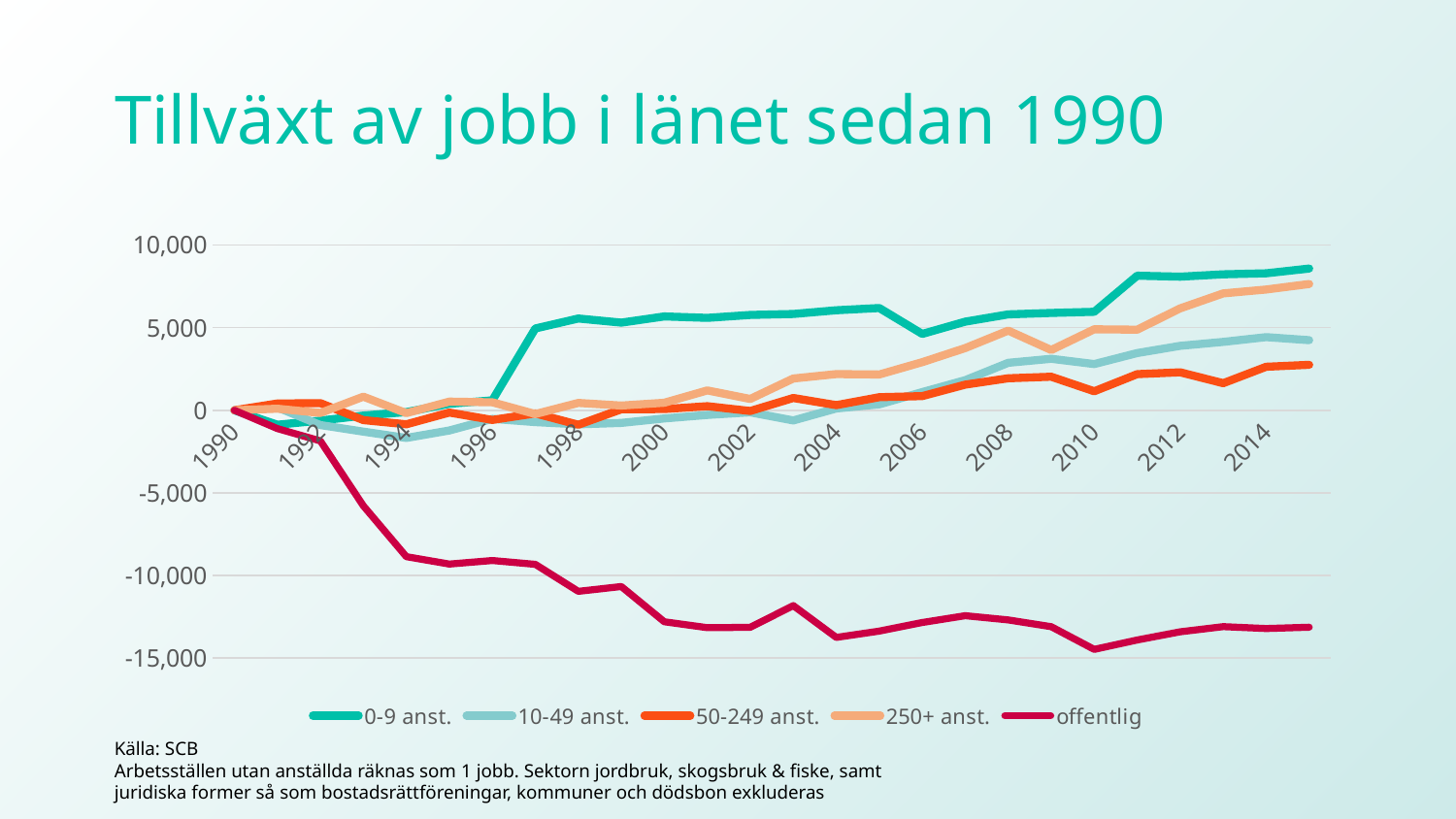
How many series does the legend list? 5 Is the value for offentlig in 2014 greater or less than -10,000? less What is the title of the chart? Tillväxt av jobb i länet sedan 1990 What kind of chart is shown on the slide? line chart What source is cited below the chart? SCB Is the value for 0-9 anst. in 2014 greater or less than 5,000? greater In 2014, which is larger: 250+ anst. or 10-49 anst.? 250+ anst. Is the value for 10-49 anst. in 2014 greater or less than 5,000? less Which series has the highest value at the end of the period (2014)? 0-9 anst. What is the value of all series in 1990? 0 Does the offentlig series rise or fall from 1990 to 2014? fall Which series has the lowest value at the end of the period (2014)? offentlig